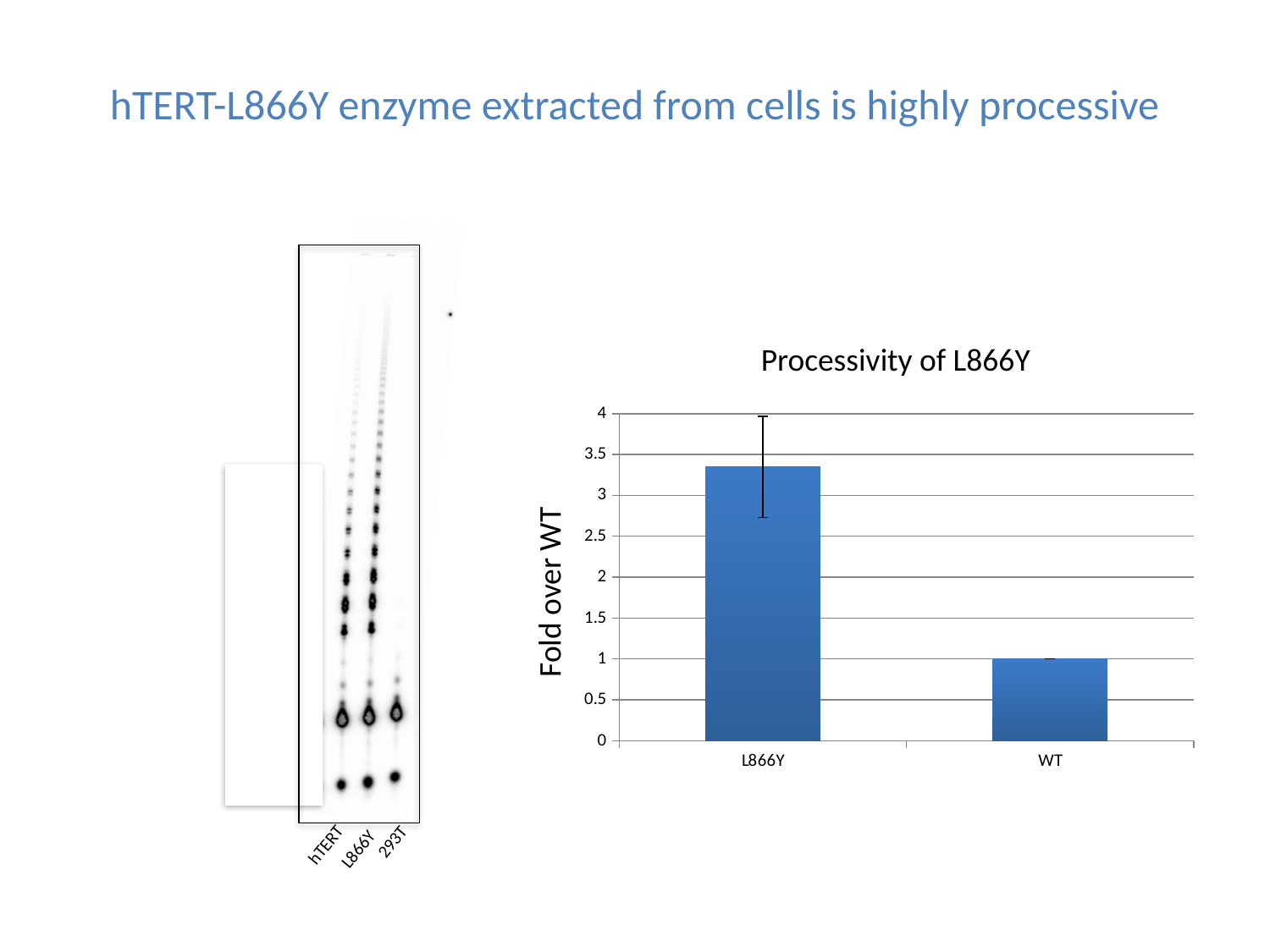
Do the values rise or fall from L866Y to WT along the x axis? fall What is the title of the chart? Processivity of L866Y Is the value for WT greater or less than 2? less What is the label of the y axis of the chart? Fold over WT Which is larger, the value for L866Y or the value for WT? L866Y What is the value for WT in the chart? 1 Which category has the lowest value in the chart? WT What kind of chart is shown on the slide? bar chart Is the value for L866Y greater or less than 3? greater How many categories are plotted in the chart? 2 Which category has the highest value in the chart? L866Y Is the value for L866Y greater or less than 3.5? less